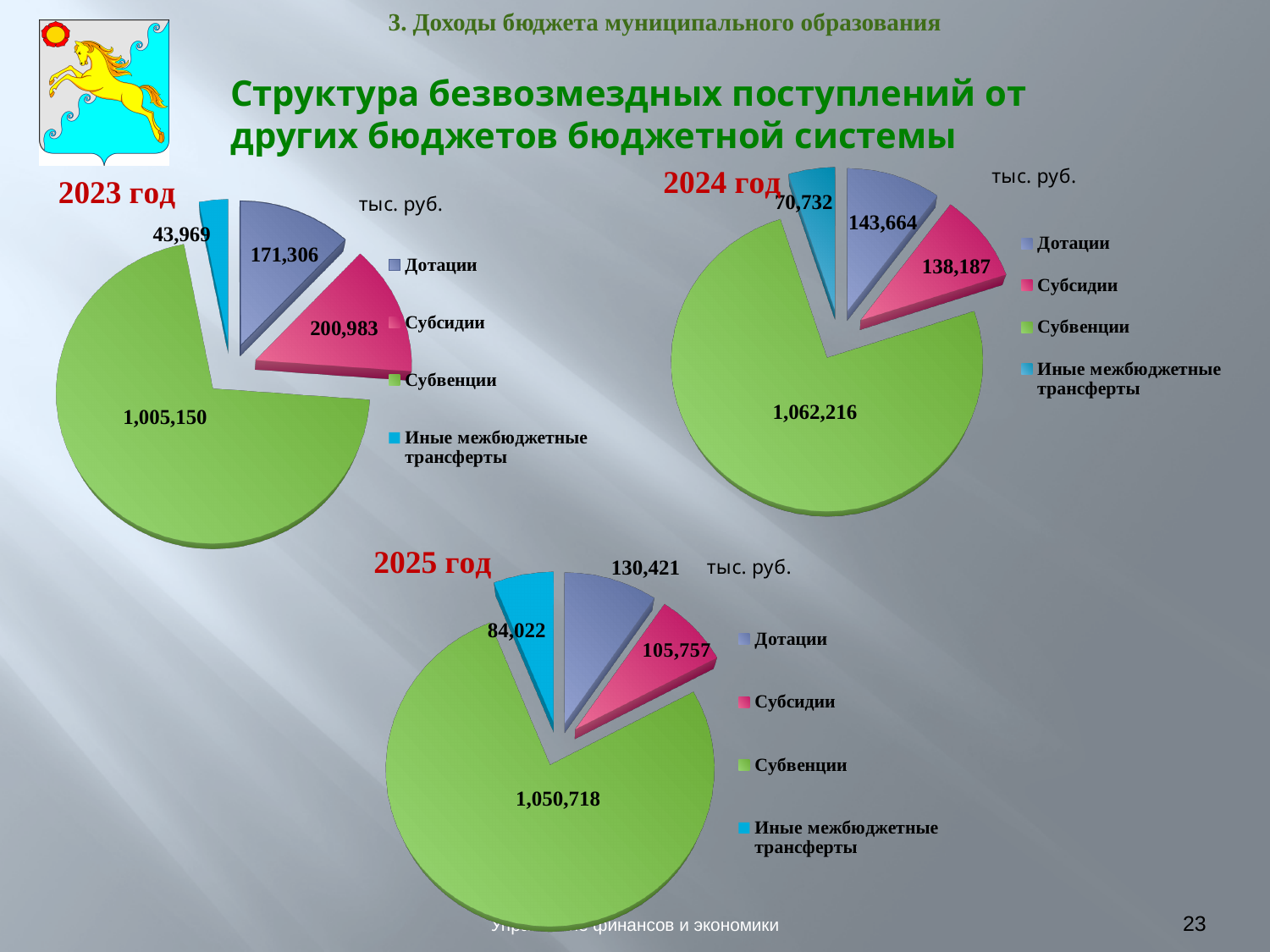
In the 2024 год chart, which category has the largest value? Субвенции How many pie charts are shown on the slide? 3 In the 2024 год chart, what is the value for Дотации? 143,664 How many categories does the legend of the 2025 год chart list? 4 In the 2024 год chart, which is larger: Дотации or Субсидии? Дотации In the 2023 год chart, what is the value for Иные межбюджетные трансферты? 43,969 In the 2025 год chart, what is the difference between Дотации and Субсидии? 24,664 In the 2023 год chart, what is the difference between Субсидии and Дотации? 29,677 What type of chart is used for the 2023 год chart? pie chart In the 2023 год chart, which category has the smallest value? Иные межбюджетные трансферты In the 2023 год chart, what is the value for Субвенции? 1,005,150 In the 2025 год chart, what is the value for Субсидии? 105,757